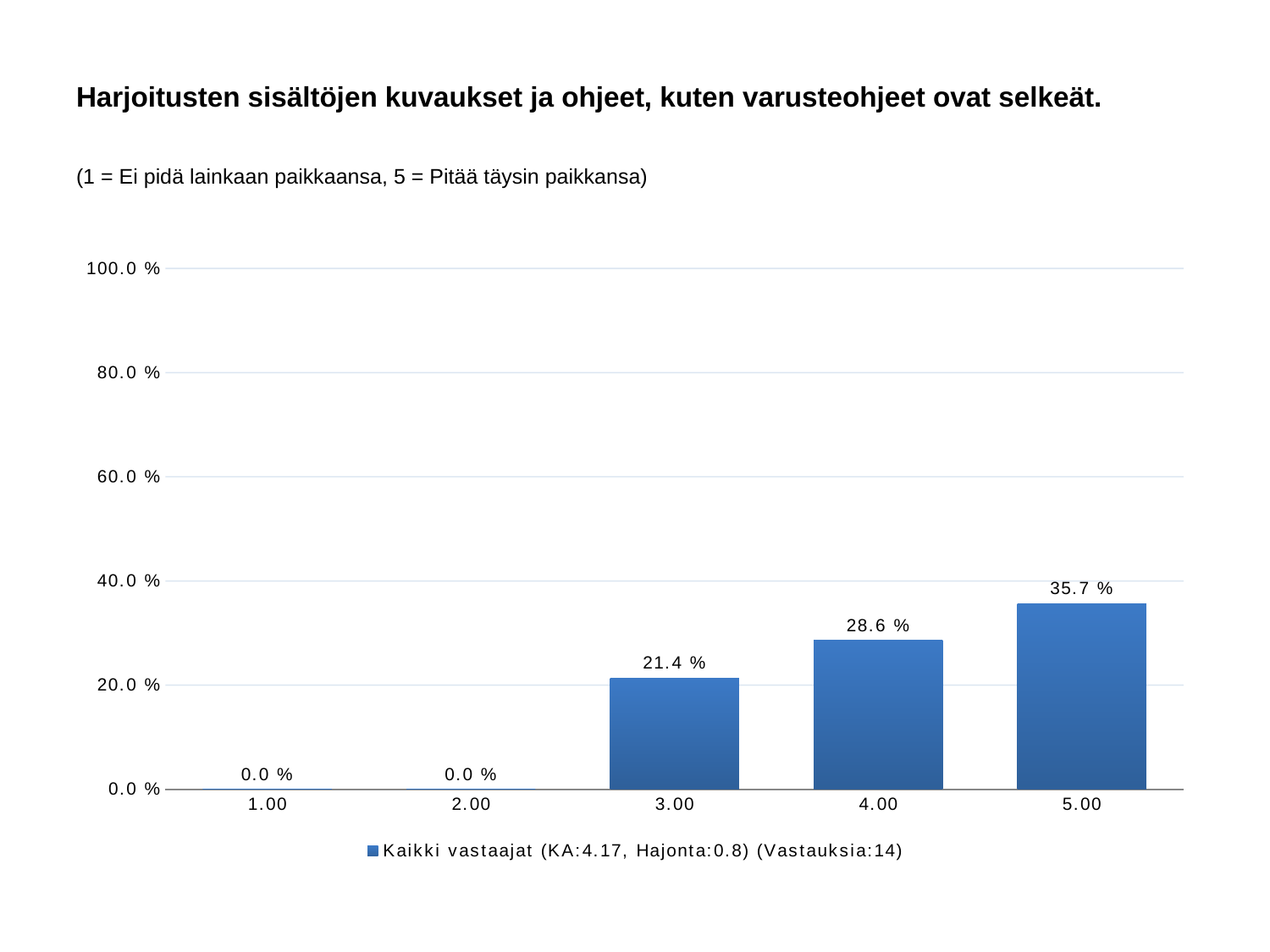
Which category has the highest value? 5.00 Which is larger, the value for 3.00 or the value for 4.00? 4.00 What is the value for category 1.00? 0.0 % Do the values rise or fall from 1.00 to 5.00 along the x axis? rise What is the value for category 3.00? 21.4 % What kind of chart is shown? bar chart How many categories are shown on the x axis? 5 What is the value for category 5.00? 35.7 % How many series does the legend list? 1 What is the difference between the values for 5.00 and 4.00? 7.1 % Is the value for 5.00 greater or less than 40.0 %? less What is the difference between the values for 4.00 and 3.00? 7.2 %